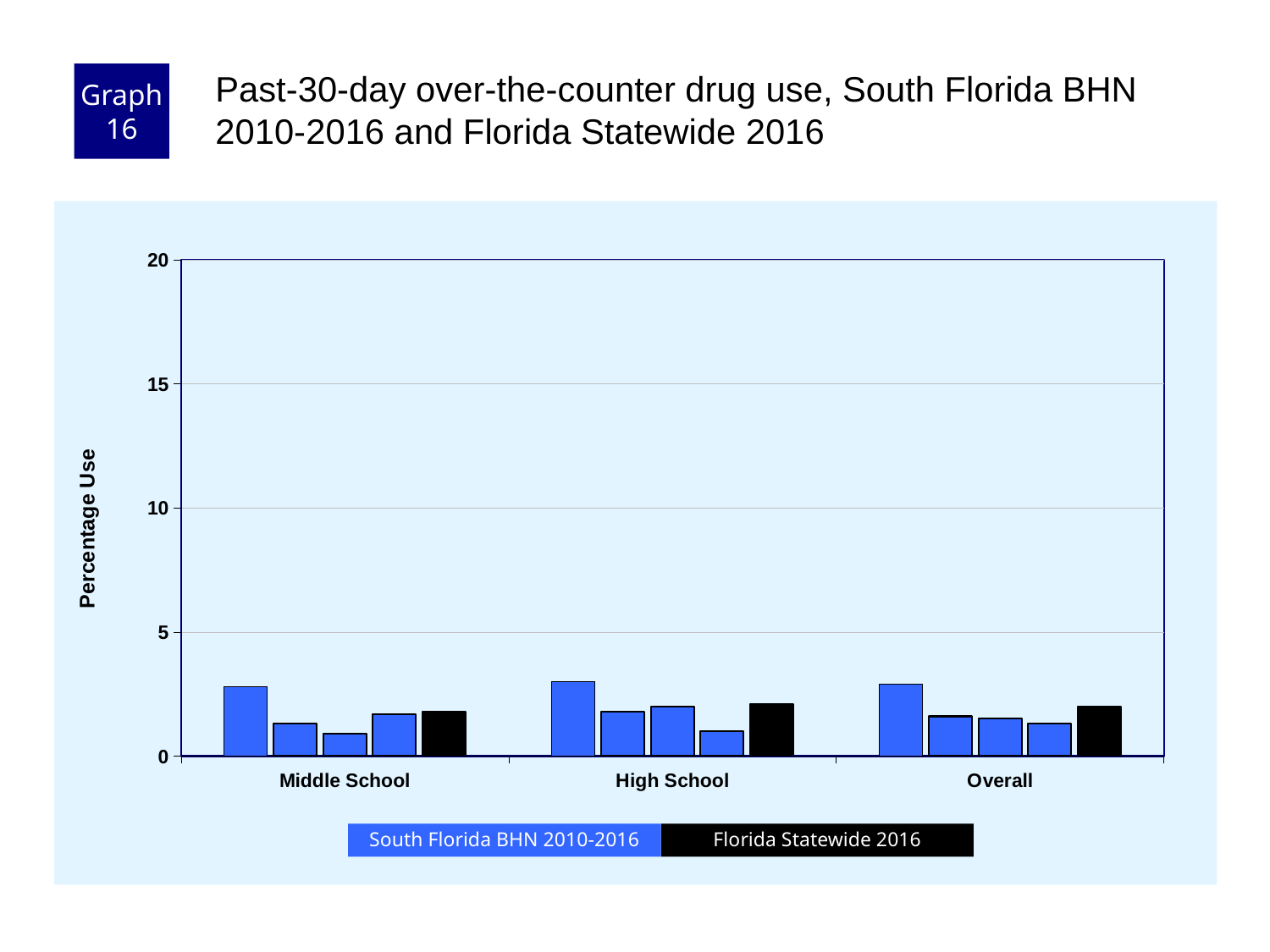
Are any of the bars in the chart greater than 10? no How many series does the legend list? 2 For High School, which is larger: the first (leftmost) South Florida BHN bar or the Florida Statewide 2016 bar? the first South Florida BHN bar How many categories are shown on the x axis? 3 What is the title of the y axis? Percentage Use What is the highest value shown on the y axis? 20 Is the Florida Statewide 2016 value for Middle School greater or less than 5? less Which colour represents Florida Statewide 2016 in the legend? black What kind of chart is shown on the slide? bar chart Is the Florida Statewide 2016 value for Overall greater or less than 5? less For Middle School, which is larger: the first (leftmost) South Florida BHN bar or the Florida Statewide 2016 bar? the first South Florida BHN bar